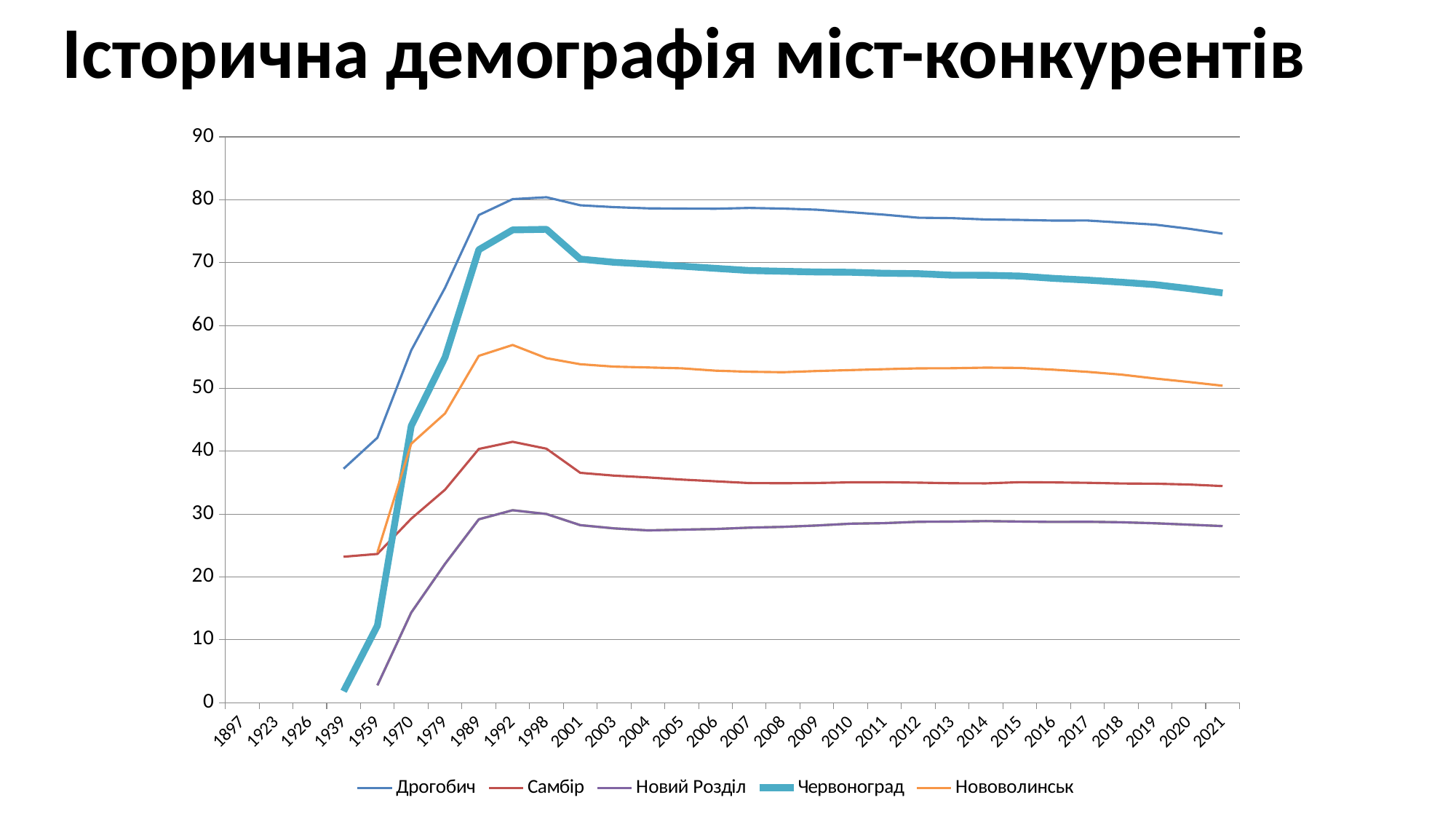
Is the value for Дрогобич in 2021 greater or less than 70? greater Is the value for Нововолинськ in 2021 greater or less than 60? less Is the value for Червоноград in 2021 greater or less than 60? greater Does the Дрогобич line rise or fall from 2001 to 2021? fall What kind of chart is shown on the slide? line chart Which series is drawn with the thickest line? Червоноград Which series has the lowest value in 2021? Новий Розділ How many series does the legend list? 5 How many year labels are shown along the x axis? 30 Which series has the highest value in 2021? Дрогобич In 2021, which is larger: the value for Червоноград or the value for Нововолинськ? Червоноград